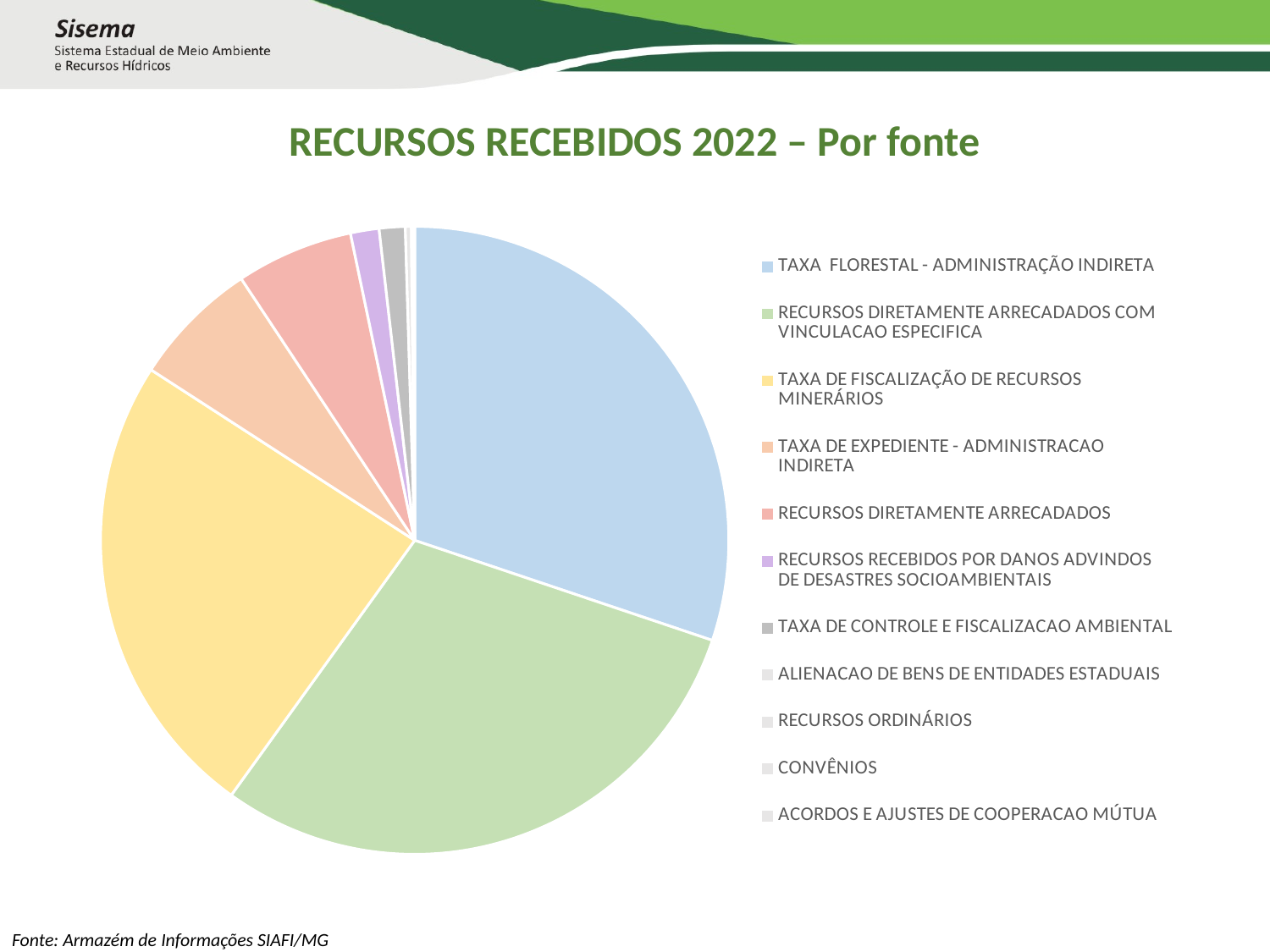
What colour is the slice for TAXA FLORESTAL - ADMINISTRAÇÃO INDIRETA? Light blue Which is larger: the slice for TAXA DE EXPEDIENTE - ADMINISTRACAO INDIRETA or the slice for TAXA DE CONTROLE E FISCALIZACAO AMBIENTAL? TAXA DE EXPEDIENTE - ADMINISTRACAO INDIRETA Which is larger: the slice for RECURSOS DIRETAMENTE ARRECADADOS COM VINCULACAO ESPECIFICA or the slice for RECURSOS DIRETAMENTE ARRECADADOS? RECURSOS DIRETAMENTE ARRECADADOS COM VINCULACAO ESPECIFICA Which is larger: the slice for TAXA DE FISCALIZAÇÃO DE RECURSOS MINERÁRIOS or the slice for RECURSOS RECEBIDOS POR DANOS ADVINDOS DE DESASTRES SOCIOAMBIENTAIS? TAXA DE FISCALIZAÇÃO DE RECURSOS MINERÁRIOS How many categories (sources) are shown in the pie chart? 11 What is the title of the chart? RECURSOS RECEBIDOS 2022 – Por fonte What kind of chart is shown on the slide? Pie chart How many entries does the chart's legend list? 11